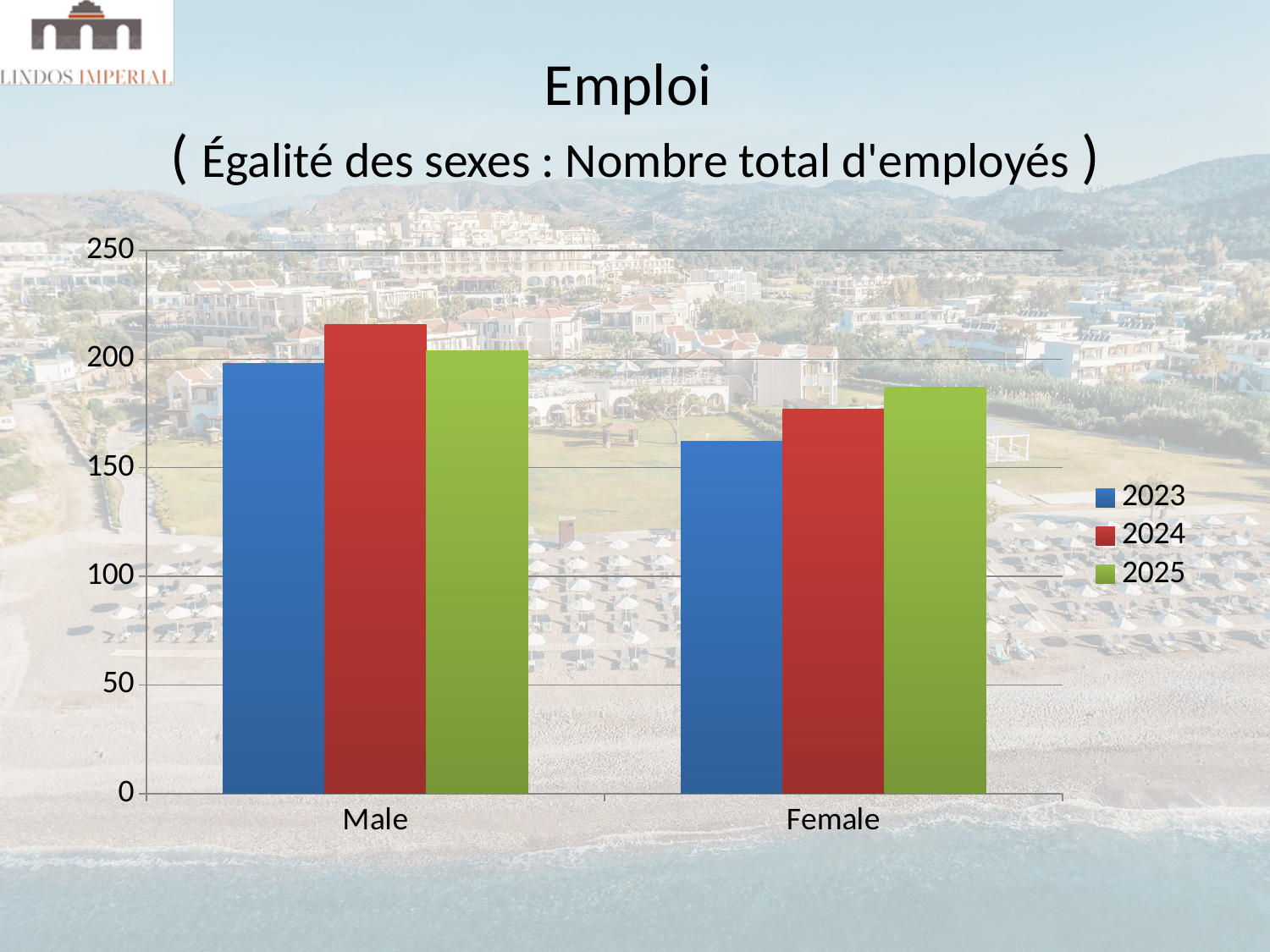
How many categories are shown on the x axis? 2 Which colour represents the 2025 series in the legend? green Which year has the lowest value for Female? 2023 Is the value for Female in 2023 greater or less than 150? greater What kind of chart is shown on the slide? bar chart How many series does the legend list? 3 Which year has the highest value for Male? 2024 Is the value for Male in 2024 greater or less than 200? greater Which is larger, the value for Female in 2025 or the value for Female in 2023? Female in 2025 Is the value for Female in 2025 greater or less than 200? less Do the values for Female rise or fall from 2023 to 2025? rise Which is larger, the value for Male in 2024 or the value for Female in 2024? Male in 2024